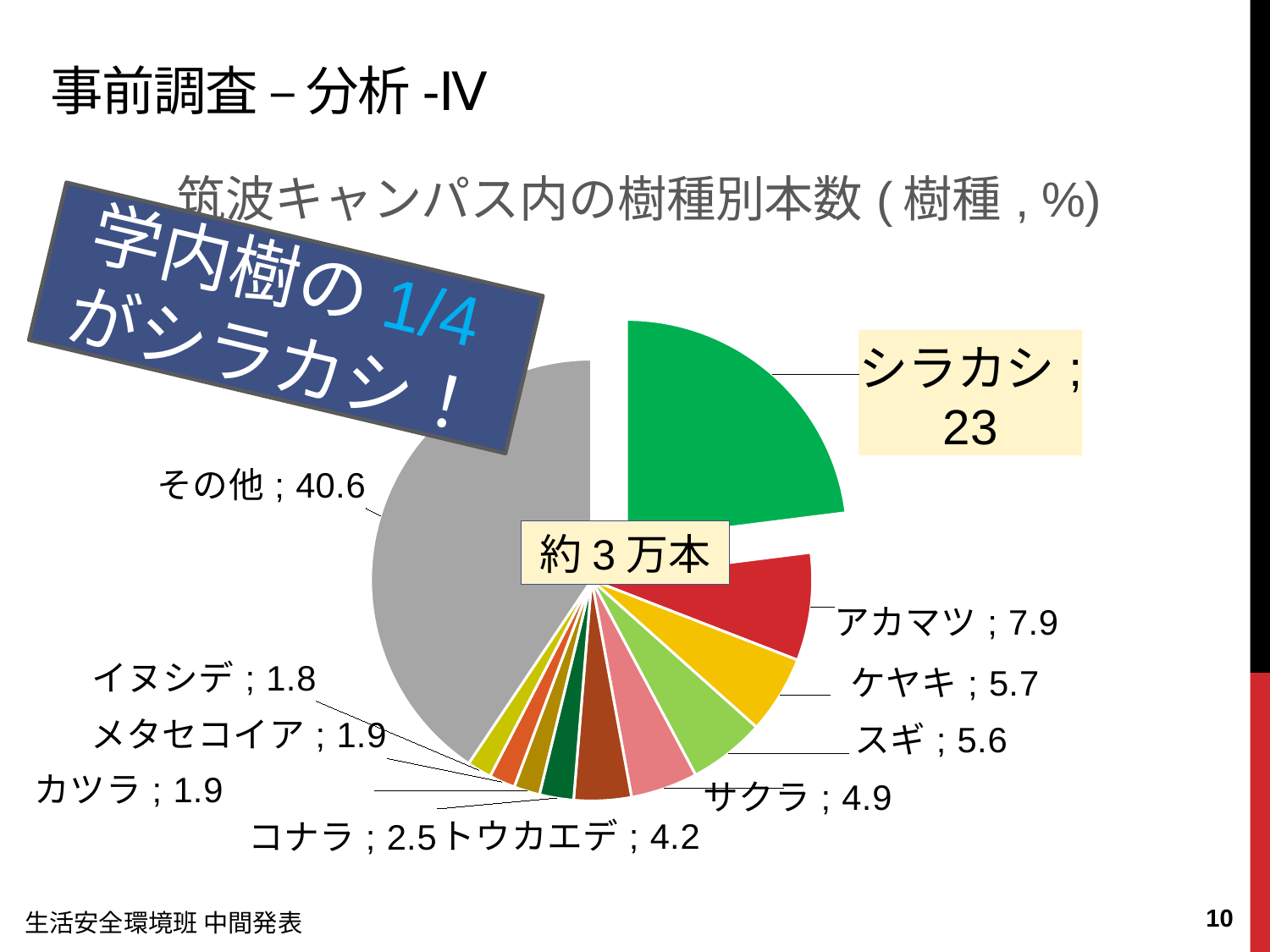
What is the value shown for トウカエデ? 4.2 What is the difference between the values for シラカシ and アカマツ? 15.1 How many categories (slices) does the pie chart have? 11 Which is larger, the value for ケヤキ or the value for サクラ? ケヤキ What is the title of the pie chart? 筑波キャンパス内の樹種別本数 ( 樹種 , %) What is the value shown for シラカシ? 23 What text is shown in the label at the centre of the pie chart? 約３万本 Which named tree species (excluding その他) has the largest slice? シラカシ What is the value shown for その他? 40.6 What kind of chart is shown on the slide? pie chart Which category has the smallest slice in the pie chart? イヌシデ What is the value shown for アカマツ? 7.9